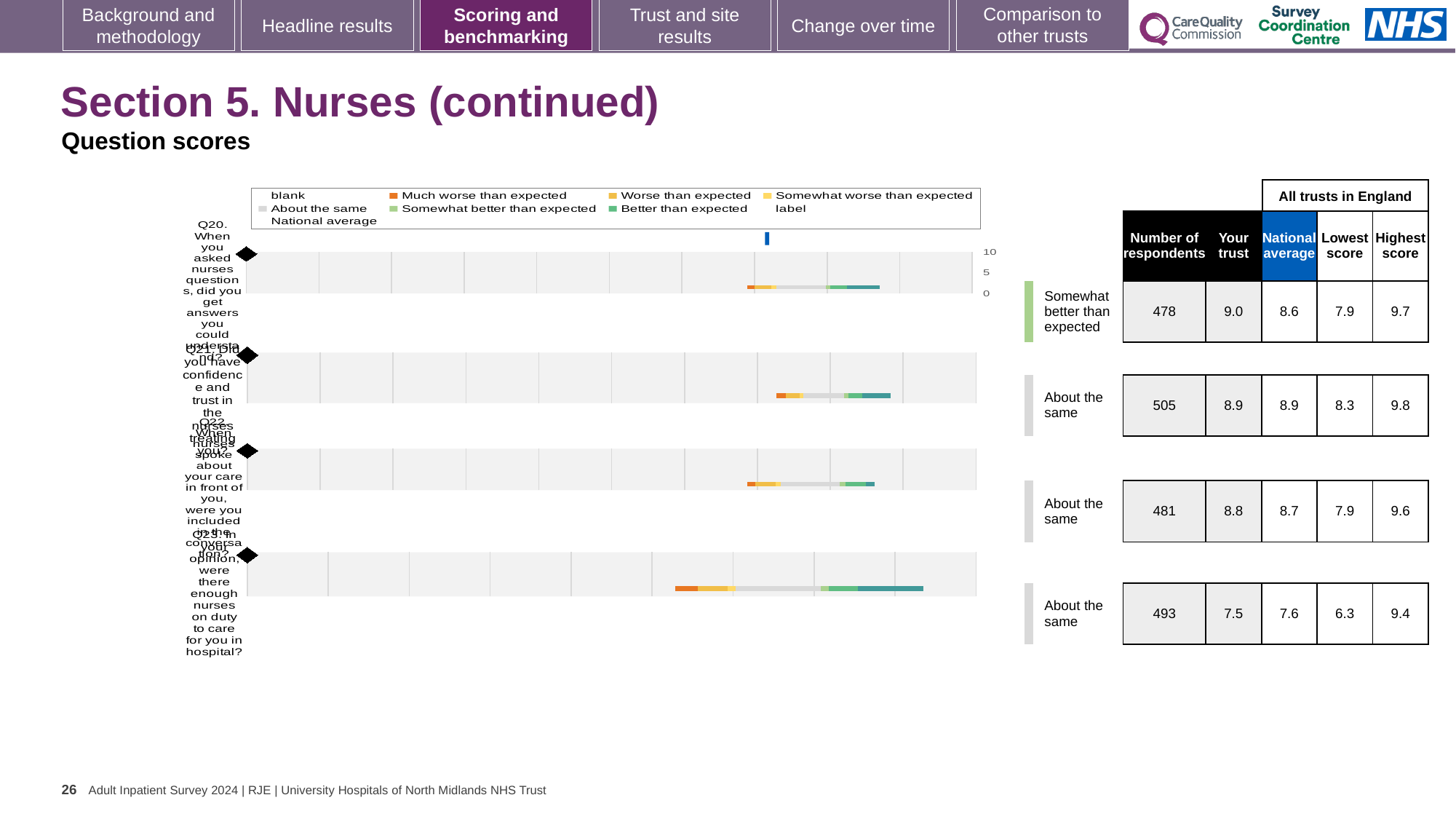
How many respondents are listed for Q21 in the table beside the chart? 505 How many questions (Q20 to Q23) are plotted as rows in the chart? 4 In the chart legend, what colour represents 'Much worse than expected'? orange What is the difference between the 'Your trust' score and the national average for Q20? 0.4 Which question has the highest 'Your trust' score in the table beside the chart? Q20 Which question has the lowest 'Your trust' score in the table beside the chart? Q23 What benchmark category is shown for Q20 next to the chart? Somewhat better than expected For Q22, which is larger: the 'Your trust' score or the national average? Your trust What kind of chart is shown on the slide? bar chart According to the table beside the chart, what is the 'Your trust' score for Q20? 9.0 What is the highest score across all trusts in England for Q23? 9.4